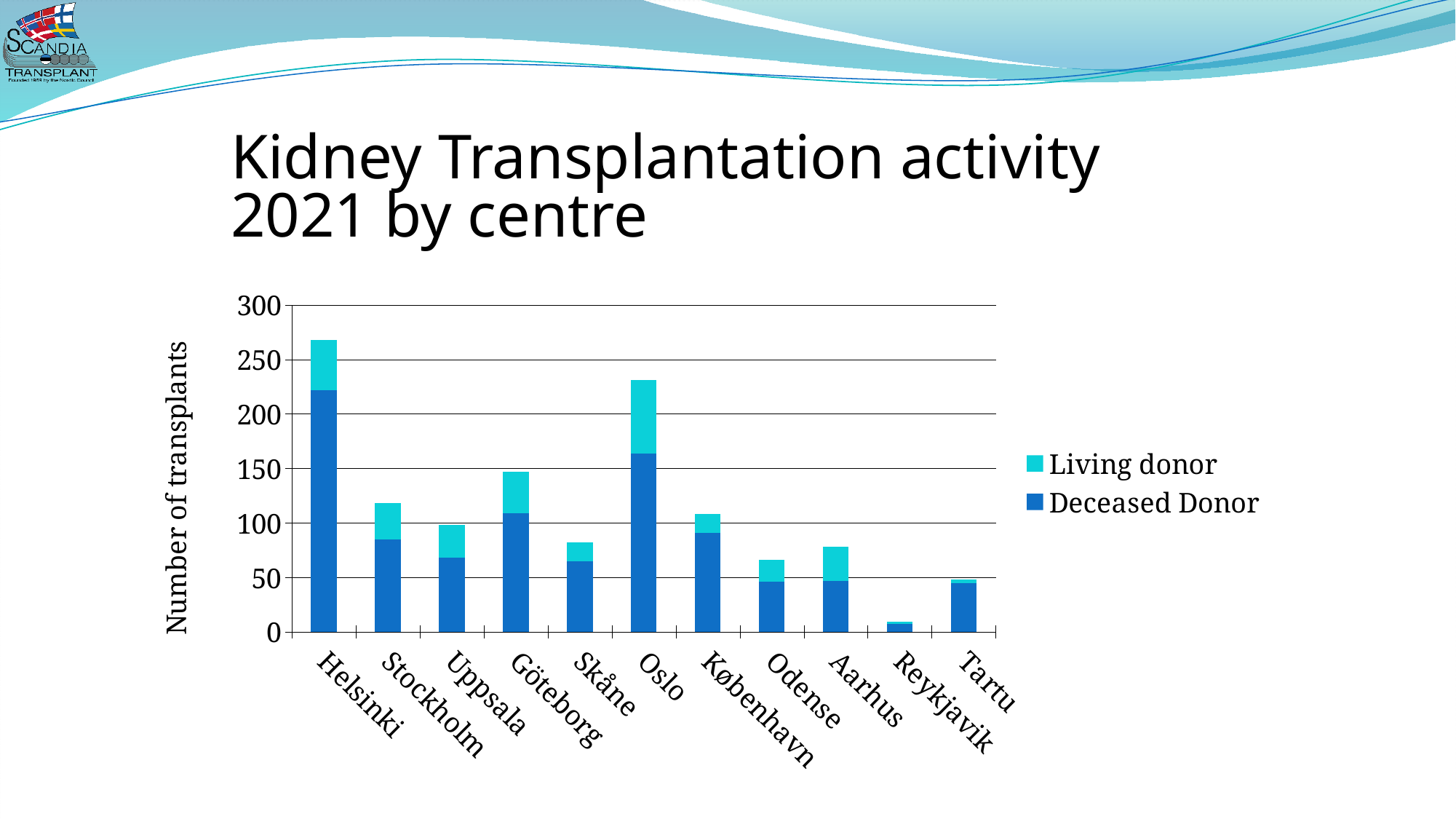
Is the Deceased Donor value for Helsinki greater or less than 200? greater Which centre has the lowest total number of transplants? Reykjavik Which centre has a larger total number of transplants, Stockholm or Uppsala? Stockholm What kind of chart is shown on the slide? Stacked bar chart Which centre has the highest total number of transplants? Helsinki Is the total number of transplants for Oslo greater or less than 200? greater How many series does the chart's legend list? 2 Is the total number of transplants for Helsinki greater or less than 250? greater Which centre has a larger total number of transplants, Odense or Aarhus? Aarhus What is the label on the vertical axis of the chart? Number of transplants How many centres are shown on the x axis of the chart? 11